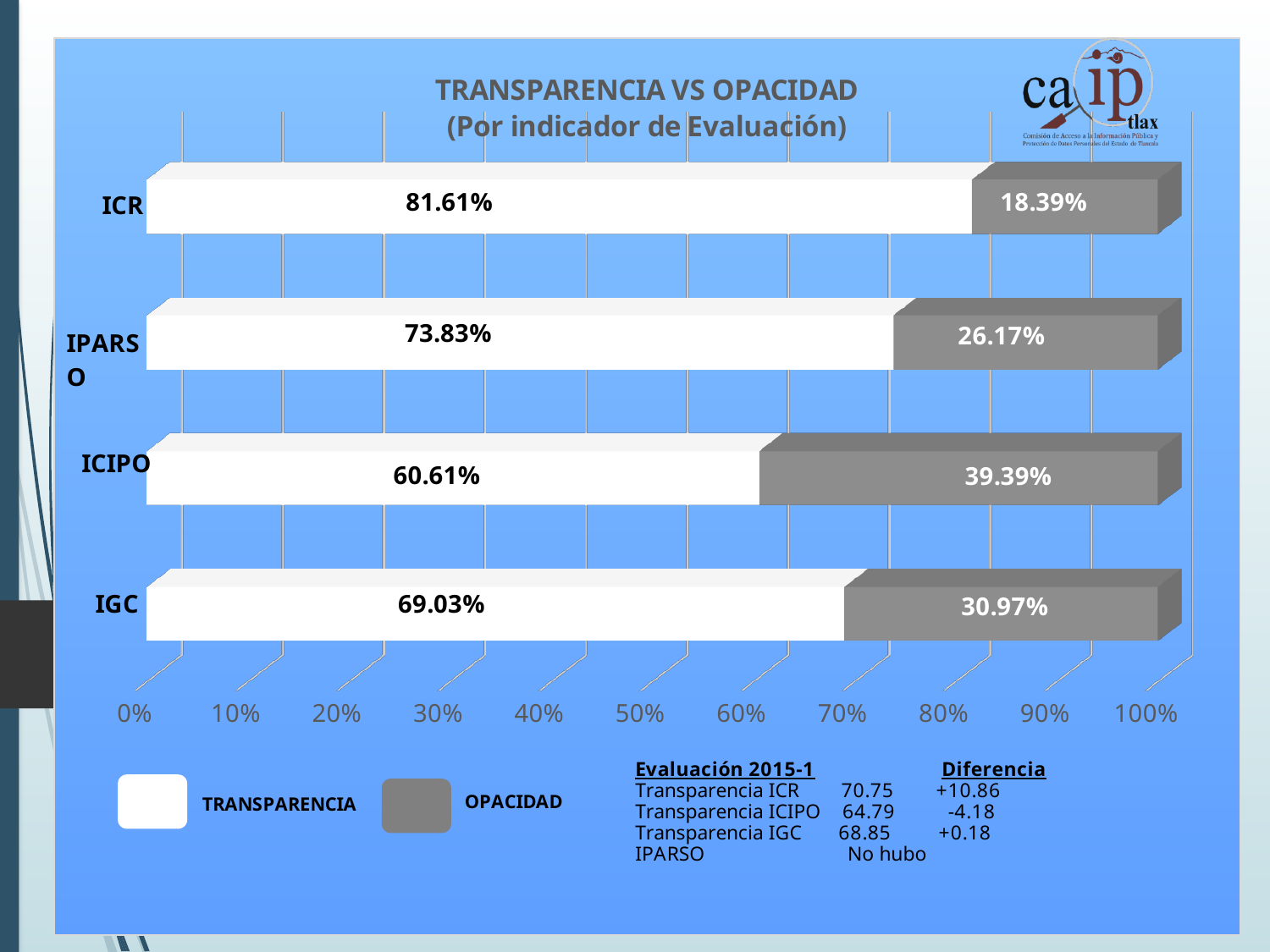
What is the difference between the TRANSPARENCIA values of ICR and ICIPO? 21.00% What is the OPACIDAD value for ICIPO? 39.39% What is the TRANSPARENCIA value for IGC? 69.03% Which is larger, the OPACIDAD value for IGC or the OPACIDAD value for IPARSO? IGC What is the TRANSPARENCIA value for ICR? 81.61% What is the OPACIDAD value for IPARSO? 26.17% How many categories are shown on the chart? 4 What is the total of the stacked bar for IGC? 100% What kind of chart is shown on the slide? Stacked bar chart Which category has the highest TRANSPARENCIA value? ICR How many series does the legend list? 2 Which category has the lowest TRANSPARENCIA value? ICIPO